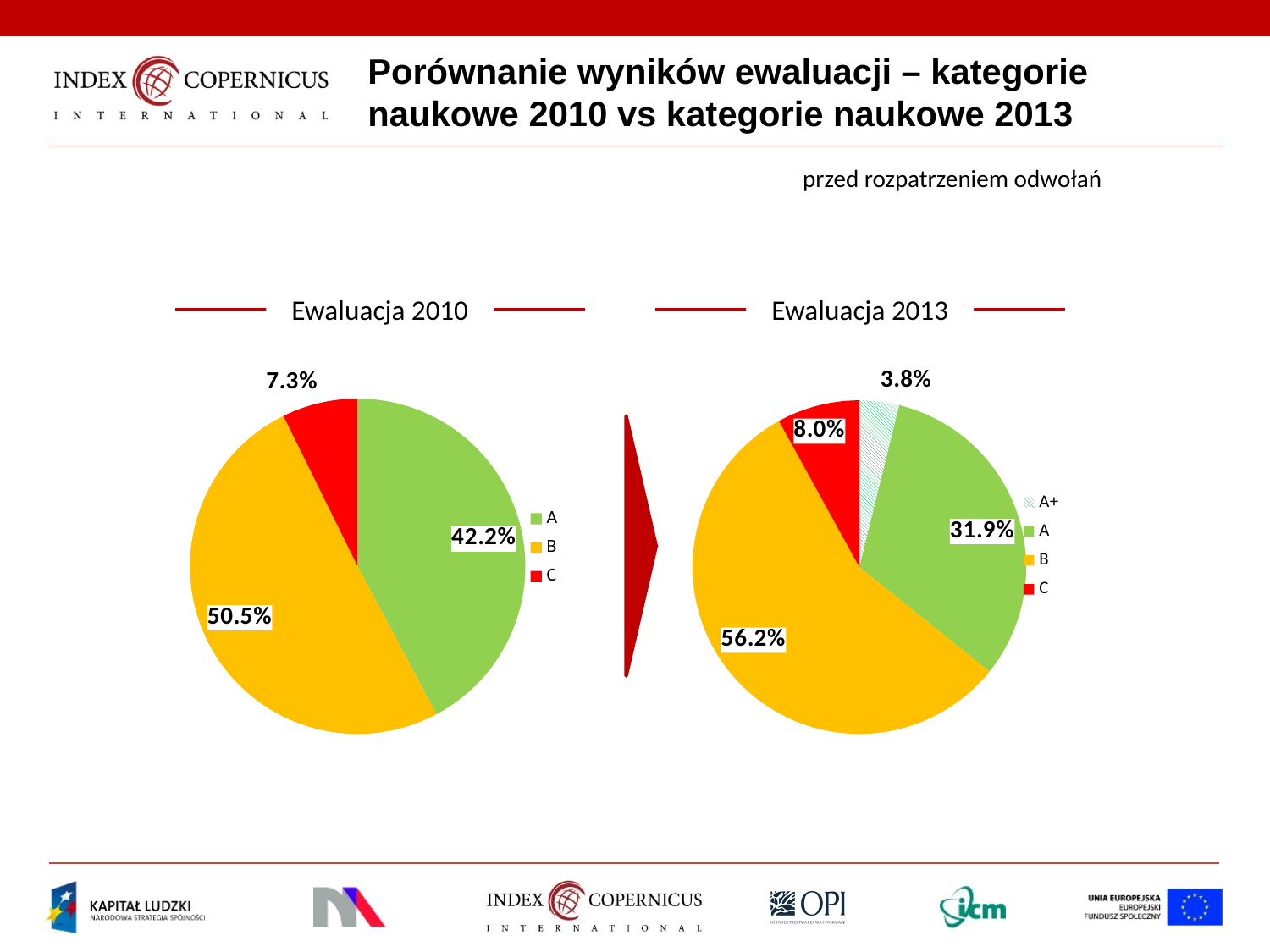
In the Ewaluacja 2013 chart, which category has the smallest share? A+ How many categories does the Ewaluacja 2013 chart show? 4 What is the difference between the share of category B and category A in the Ewaluacja 2010 chart? 8.3% Which colour represents category C in both charts? Red In the Ewaluacja 2013 chart, what share does category A+ have? 3.8% In the Ewaluacja 2010 chart, what share does category C have? 7.3% Is the share of category A larger in the Ewaluacja 2010 chart or in the Ewaluacja 2013 chart? Ewaluacja 2010 In the Ewaluacja 2010 chart, which category has the smallest share? C In the Ewaluacja 2013 chart, what share does category A have? 31.9% What type of chart is the Ewaluacja 2010 chart? Pie chart In the Ewaluacja 2010 chart, what share does category B have? 50.5% In the Ewaluacja 2013 chart, which category has the largest share? B